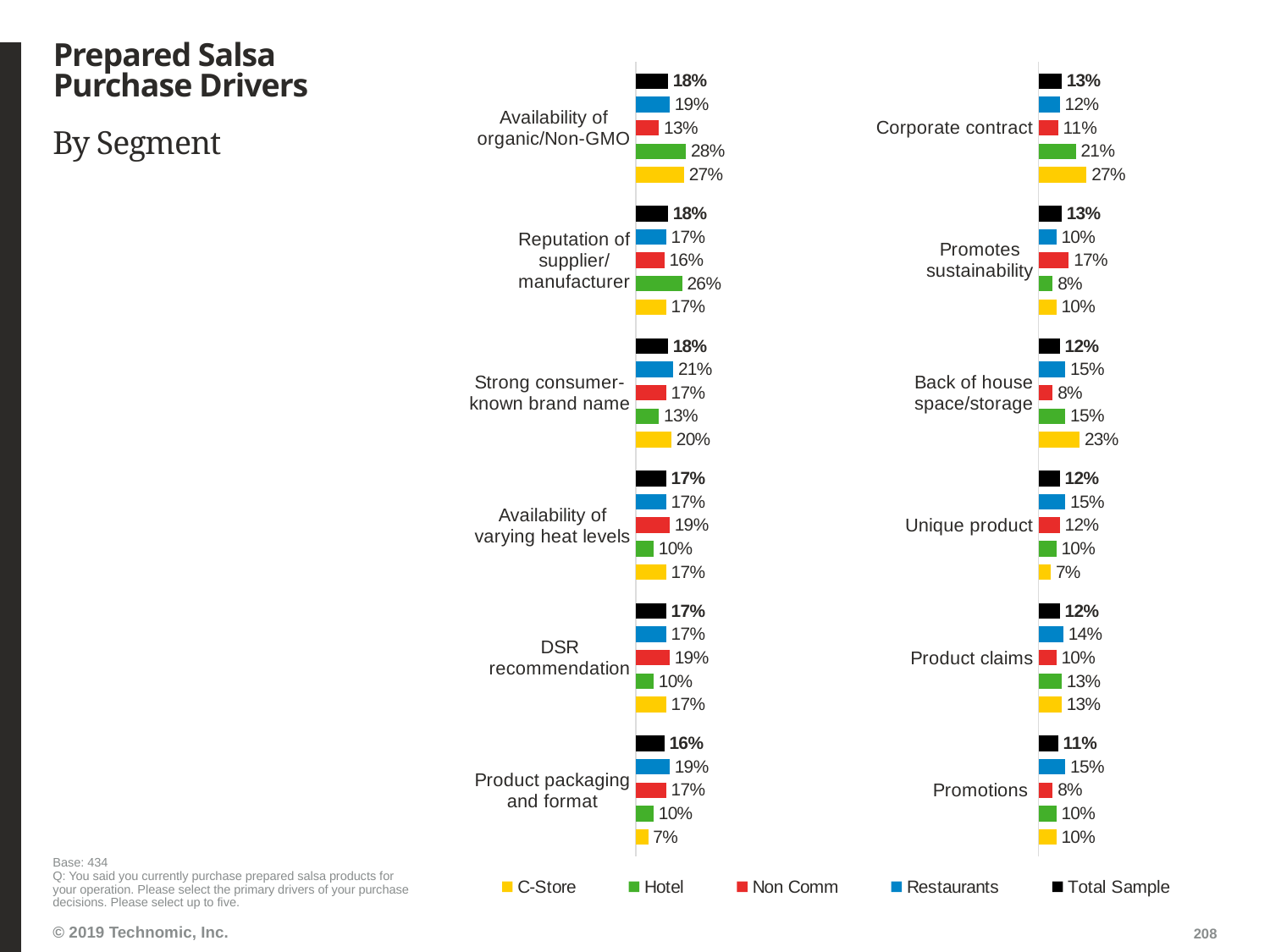
Which colour represents the Total Sample series in the legend? Black How many categories does the left chart show? 6 In the right chart, which segment has the highest value for Back of house space/storage? C-Store In the left chart, what is the Total Sample value for Product packaging and format? 16% In the left chart, what is the difference between the Hotel and Non Comm values for Availability of organic/Non-GMO? 15% In the right chart, what is the Non Comm value for Promotes sustainability? 17% In the left chart, what is the Hotel value for Availability of organic/Non-GMO? 28% In the right chart, what is the C-Store value for Corporate contract? 27% How many series does the legend list? 5 What type of chart is used on this slide? Bar chart In the right chart, which is larger for Promotions: the Restaurants value or the Non Comm value? Restaurants In the left chart, which segment has the lowest value for Product packaging and format? C-Store